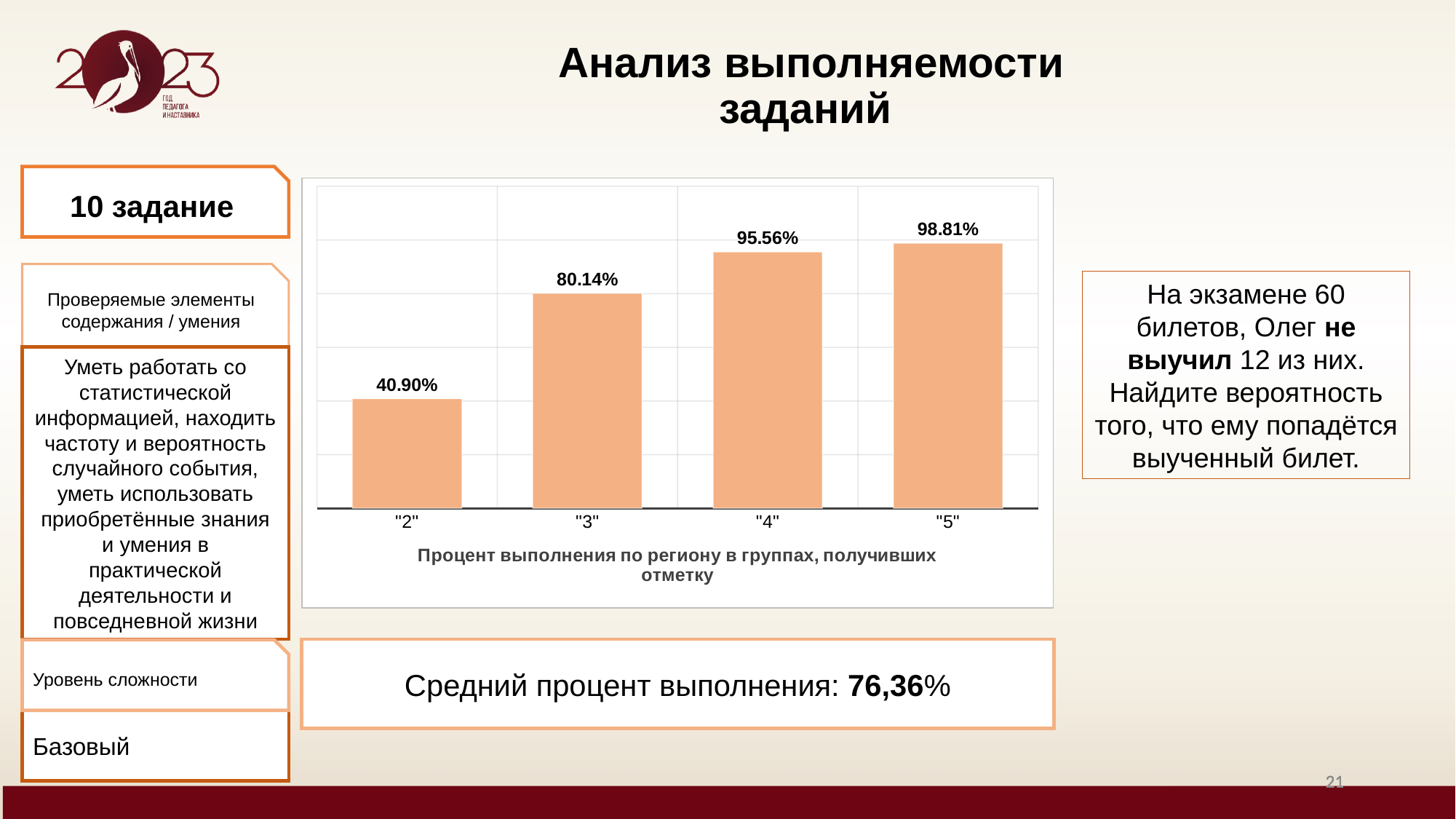
What is the completion percentage for the group that received mark "5"? 98.81% Which mark group has the lowest completion percentage? "2" What is the difference in completion percentage between the "3" group and the "2" group? 39.24% How many mark groups are shown in the chart? 4 What is the completion percentage for the group that received mark "2"? 40.90% Which group has a higher completion percentage, "3" or "4"? "4" Which mark group has the highest completion percentage? "5" What is the completion percentage for the group that received mark "4"? 95.56% What is the difference in completion percentage between the "5" group and the "4" group? 3.25% What is the completion percentage for the group that received mark "3"? 80.14% What type of chart is shown on the slide? Bar chart Do the completion percentages rise or fall as the mark increases from "2" to "5"? Rise